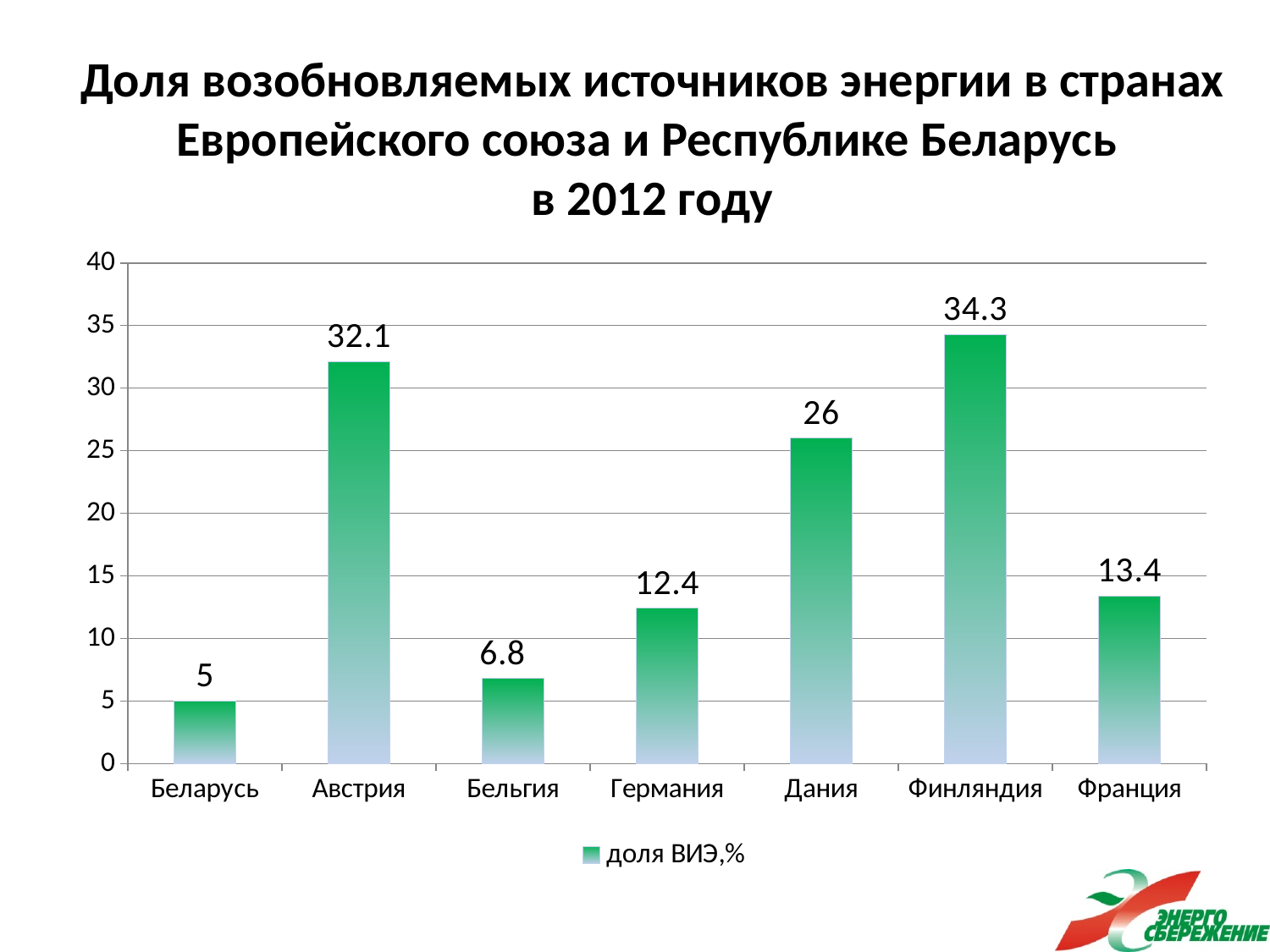
Is the value for Дания greater or less than 25? greater What series name does the legend show? доля ВИЭ,% How many countries are shown on the chart? 7 What is the value for Германия? 12.4 What is the difference between the values for Дания and Бельгия? 19.2 Which country has the lowest value? Беларусь What is the value for Беларусь? 5 Which is larger, the value for Франция or the value for Германия? Франция What kind of chart is shown on the slide? bar chart What is the value for Австрия? 32.1 Which country has the highest value? Финляндия What is the difference between the values for Финляндия and Австрия? 2.2